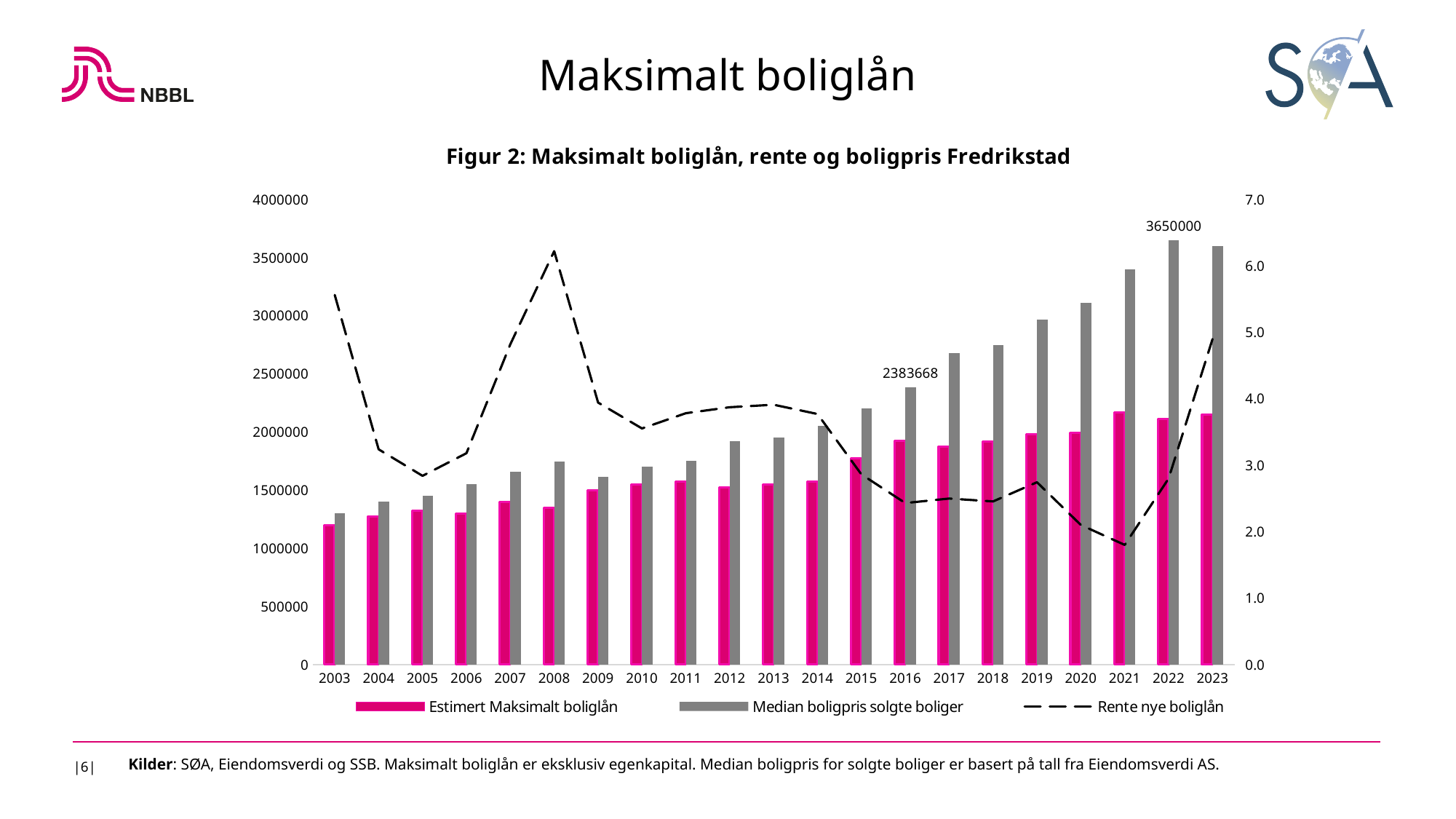
Which series is drawn as a dashed line in the chart? Rente nye boliglån How many years are shown on the x axis of the chart? 21 Which year has the larger Median boligpris solgte boliger, 2019 or 2020? 2020 What is the value of Median boligpris solgte boliger for 2016? 2383668 Which year has the lowest Estimert Maksimalt boliglån? 2003 What is the value of Median boligpris solgte boliger for 2022? 3650000 Is the value of Estimert Maksimalt boliglån for 2023 greater or less than 2000000? greater What kind of chart is shown on the slide? Bar chart combined with a line Which year has the highest Median boligpris solgte boliger? 2022 What is the difference between the Median boligpris solgte boliger values for 2022 and 2016? 1266332 How many series does the legend list? 3 Is the value of Rente nye boliglån for 2021 greater or less than 2.0? less